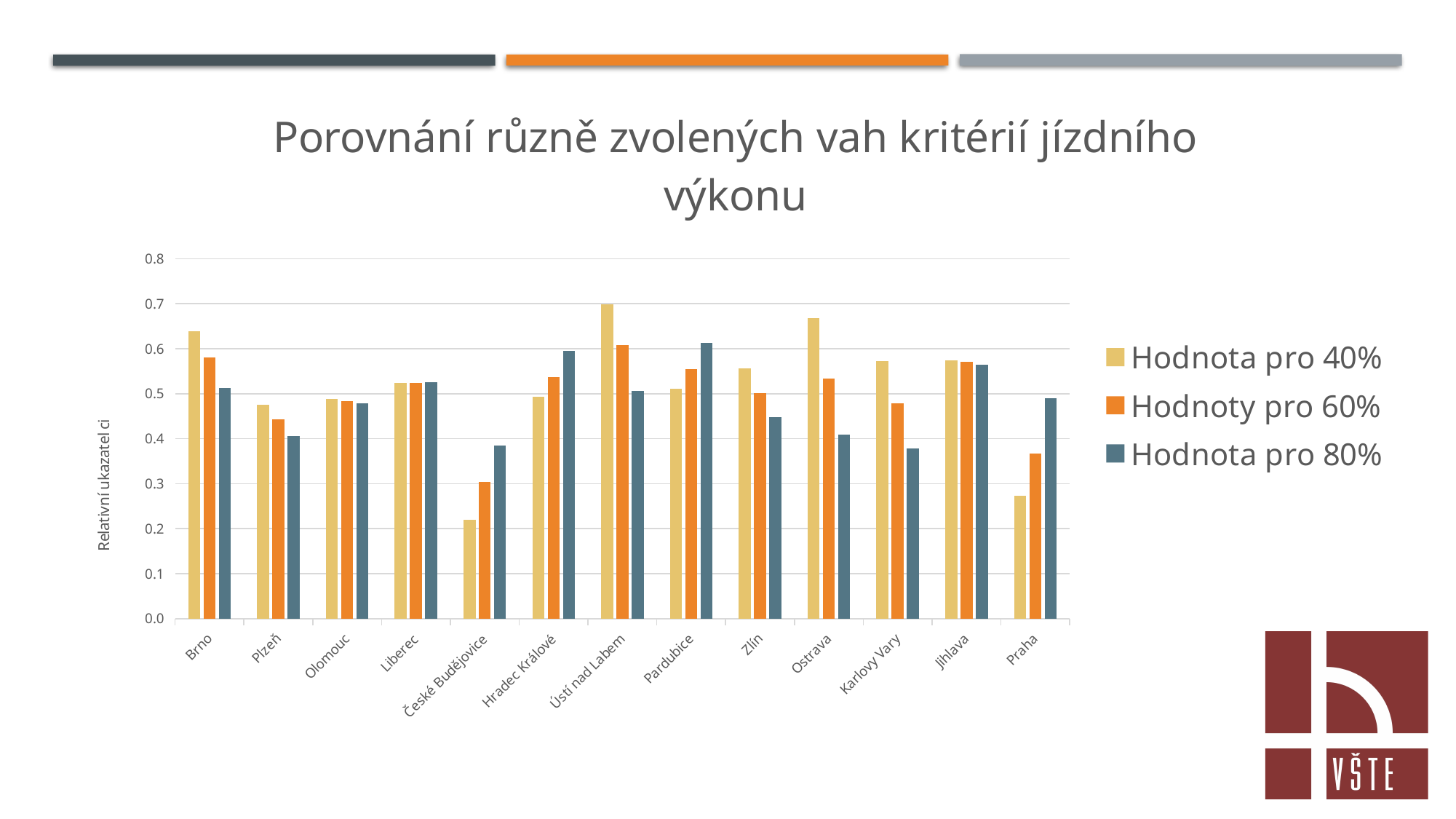
Which city has the lowest value for the series Hodnoty pro 60%? České Budějovice Which city has the lowest value for the series Hodnota pro 40%? České Budějovice For Praha, which is larger: the Hodnota pro 40% value or the Hodnota pro 80% value? Hodnota pro 80% How many cities are shown on the x axis? 13 What kind of chart is shown on the slide? bar chart How many series does the legend list? 3 Is the Hodnota pro 40% value for Praha greater or less than 0.3? less For Brno, which is larger: the Hodnota pro 40% value or the Hodnota pro 80% value? Hodnota pro 40% What is the label of the vertical axis? Relativní ukazatel ci Which city has the highest value for the series Hodnota pro 40%? Ústí nad Labem Is the Hodnota pro 80% value for Ostrava greater or less than 0.5? less Is the Hodnota pro 40% value for Brno greater or less than 0.6? greater